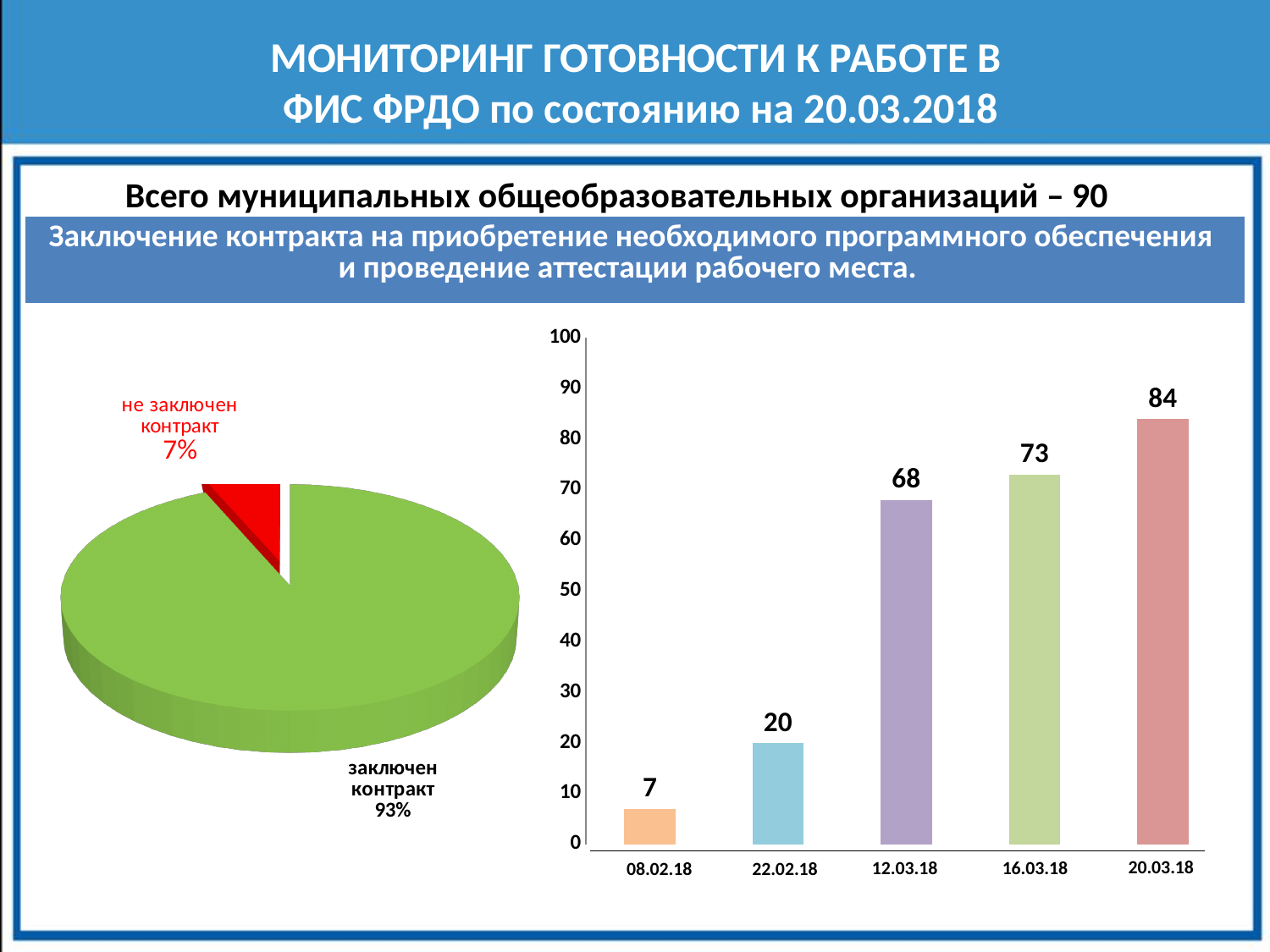
In the bar chart on the right, which date has the highest value? 20.03.18 In the bar chart on the right, what is the value for 08.02.18? 7 In the bar chart on the right, how many dates are shown on the x axis? 5 In the bar chart on the right, which is larger: the value for 22.02.18 or the value for 12.03.18? 12.03.18 In the bar chart on the right, which date has the lowest value? 08.02.18 What kind of chart is the chart on the right side of the slide? bar chart In the bar chart on the right, do the values rise or fall from 08.02.18 to 20.03.18? rise In the pie chart on the left, what colour is the 'не заключен контракт' slice? red In the bar chart on the right, what is the value for 12.03.18? 68 In the bar chart on the right, what is the difference between the values for 20.03.18 and 16.03.18? 11 In the pie chart on the left, what share is labelled 'заключен контракт'? 93% In the pie chart on the left, what share is labelled 'не заключен контракт'? 7%